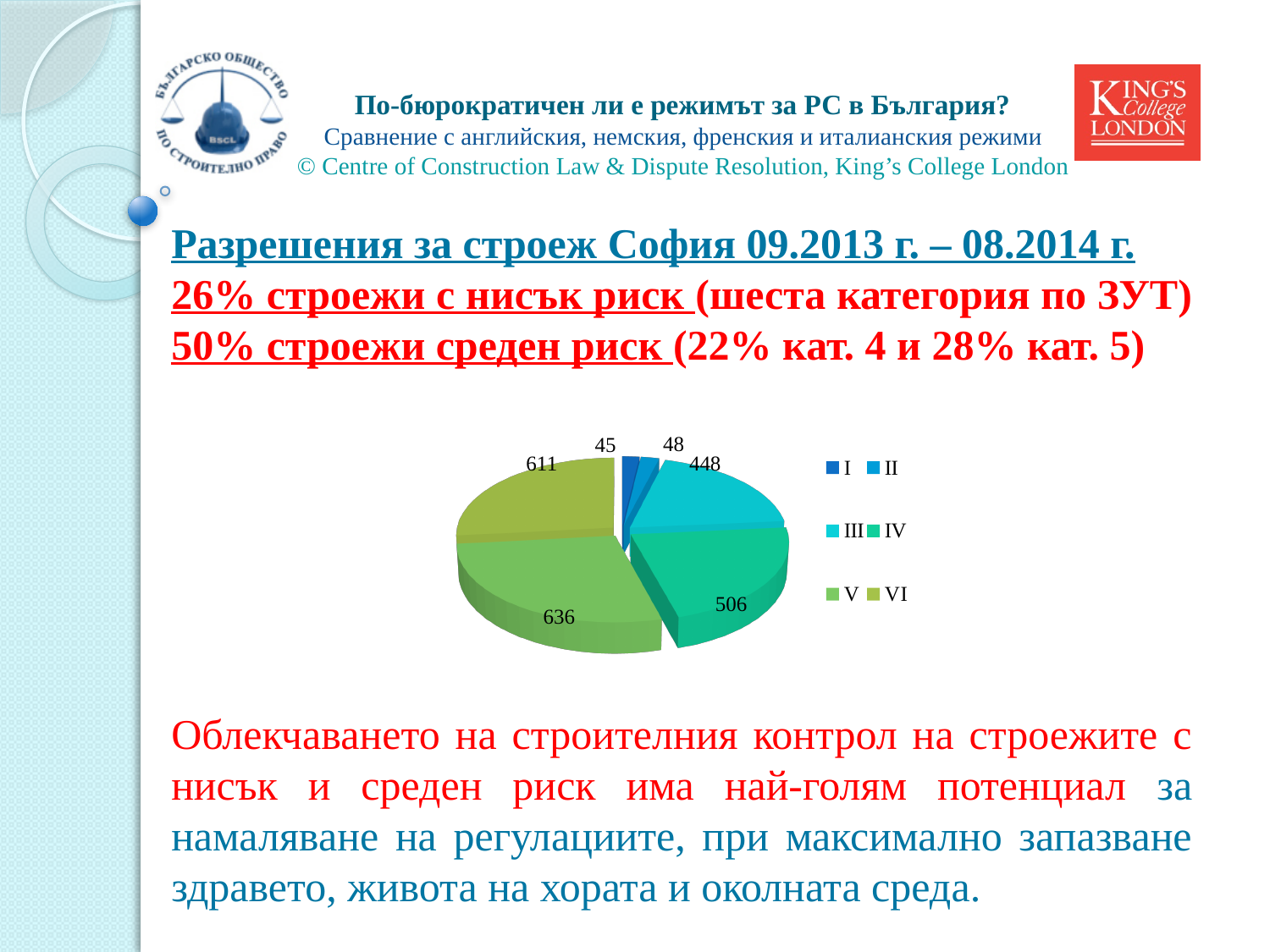
Which category has the largest slice in the pie chart? V What is the value for category I in the pie chart? 45 What are the legend entries of the pie chart? I, II, III, IV, V, VI What is the value for category VI in the pie chart? 611 What is the value for category V in the pie chart? 636 Which category has the smallest slice in the pie chart? I Which is larger, the value for category V or the value for category VI? V What is the value for category III in the pie chart? 448 How many categories does the pie chart have? 6 What type of chart is shown on the slide? pie chart What share of the pie does category IV represent? 22% What is the difference between the values for category IV and category III? 58